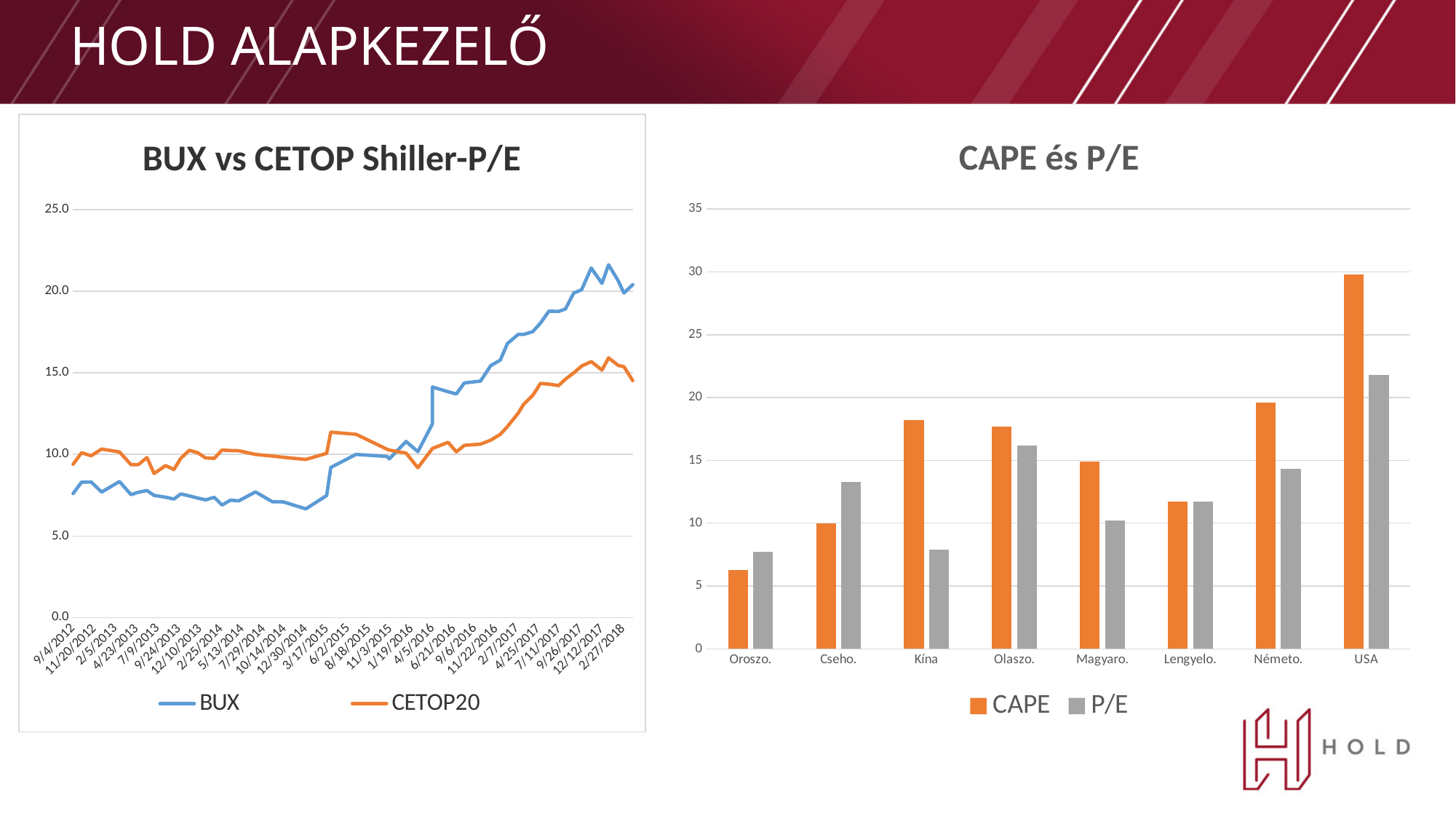
In the 'CAPE és P/E' chart, is the P/E value for Kína greater or less than 10? less In the 'CAPE és P/E' chart, is the CAPE value for USA greater or less than 25? greater How many countries are shown on the x axis of the 'CAPE és P/E' chart? 8 In the 'CAPE és P/E' chart, which is larger for Cseho., CAPE or P/E? P/E What kind of chart is the 'CAPE és P/E' chart on the right? bar chart In the 'CAPE és P/E' chart, which country has the lowest CAPE value? Oroszo. In the 'BUX vs CETOP Shiller-P/E' chart, does the BUX series overall rise or fall from 9/4/2012 to 2/27/2018? rise How many series does the legend of the 'BUX vs CETOP Shiller-P/E' chart list? 2 In the 'BUX vs CETOP Shiller-P/E' chart, is the BUX value at 9/4/2012 greater or less than 10.0? less In the 'CAPE és P/E' chart, which country has the highest CAPE value? USA In the 'BUX vs CETOP Shiller-P/E' chart, which series is higher at 2/27/2018, BUX or CETOP20? BUX What kind of chart is the 'BUX vs CETOP Shiller-P/E' chart on the left? line chart